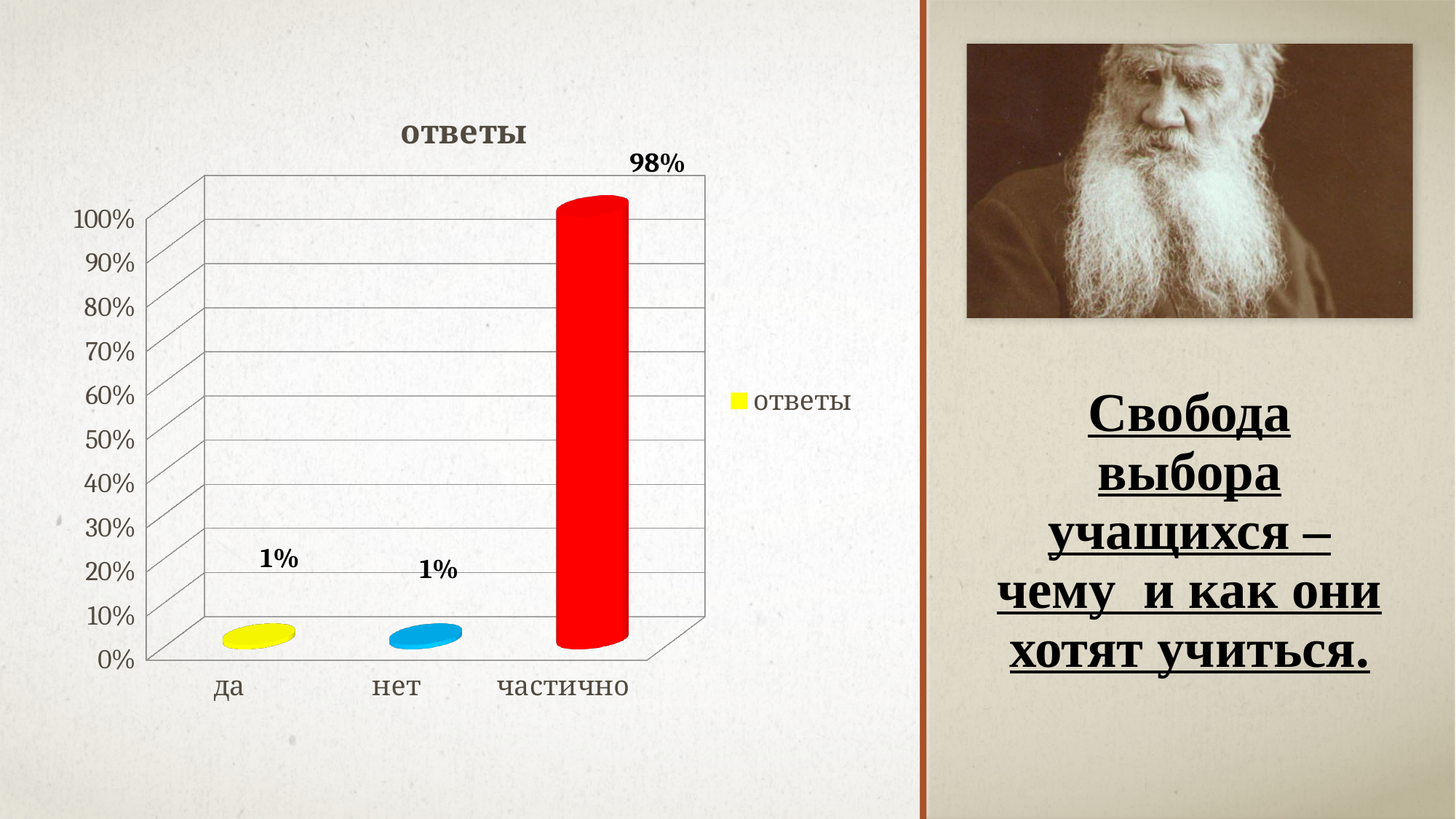
How many categories are shown on the x axis? 3 What is the value for да? 1% What kind of chart is shown? bar chart What is the value for частично? 98% Which is larger, the value for частично or the value for нет? частично What is the title of the chart? ответы What is the difference between the values for частично and да? 97% What is the value for нет? 1% Which category has the highest value? частично Is the value for частично greater or less than 90%? greater How many series does the legend list? 1 Is the value for да greater or less than 10%? less